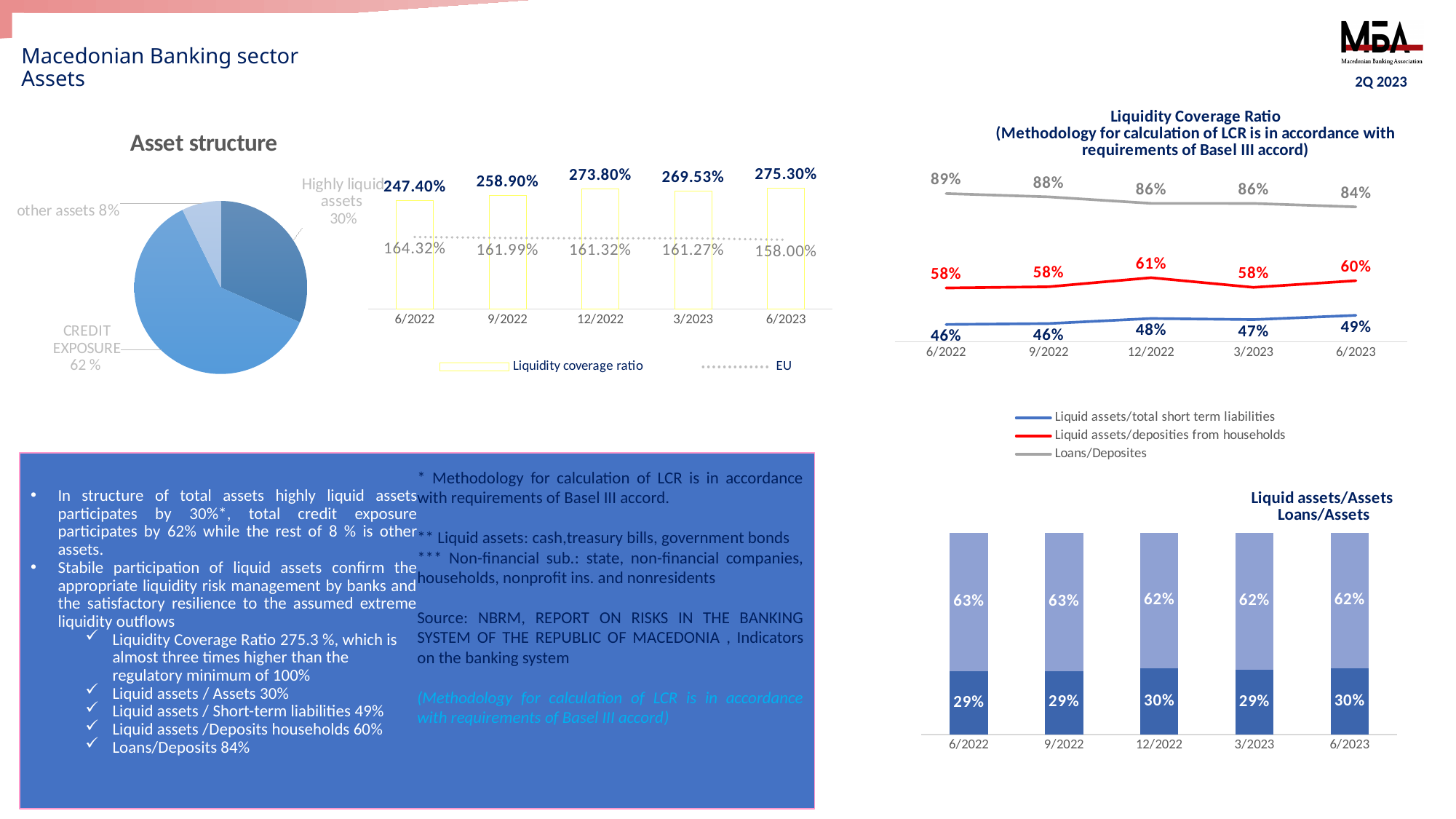
In the Liquidity Coverage Ratio line chart on the right, which is larger at 12/2022: Liquid assets/deposities from households or Liquid assets/total short term liabilities? Liquid assets/deposities from households In the Asset structure pie chart, which category has the largest slice? CREDIT EXPOSURE In the Liquidity coverage ratio chart (top middle), what is the EU value for 6/2022? 164.32% In the Asset structure pie chart, what share do highly liquid assets have? 30% In the Liquid assets/Assets Loans/Assets chart, what is the total of the stacked bar for 6/2022? 92% In the Liquidity coverage ratio chart (top middle), which period has the lowest Liquidity coverage ratio? 6/2022 In the Liquidity Coverage Ratio line chart on the right, what is the Loans/Deposites value for 6/2023? 84% In the Liquidity Coverage Ratio line chart on the right, how many series does the legend list? 3 In the Liquidity coverage ratio chart (top middle), does the EU series rise or fall from 6/2022 to 6/2023? fall In the Asset structure pie chart, how many slices are there? 3 In the Liquidity coverage ratio chart (top middle), what is the difference between the Liquidity coverage ratio and the EU value for 12/2022? 112.48% In the Liquidity coverage ratio chart (top middle), what is the Liquidity coverage ratio for 6/2023? 275.30%